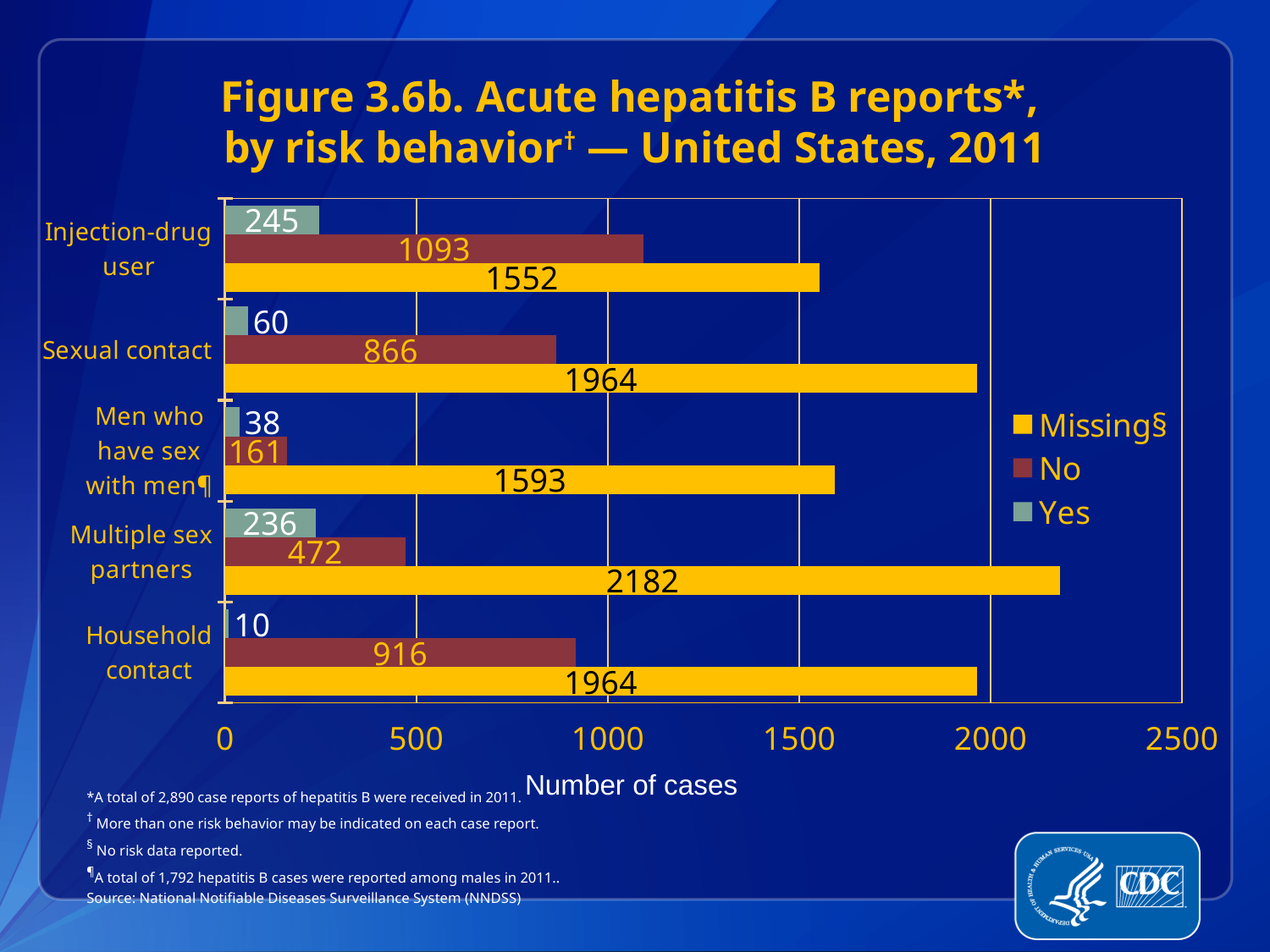
What kind of chart is shown on the slide? Bar chart What is the difference between the 'No' values for Injection-drug user and Sexual contact? 227 How many risk behavior categories are shown on the chart? 5 What is the label of the x axis? Number of cases How many series does the legend list? 3 What is the 'Missing' value for Multiple sex partners? 2182 Is the 'Missing' value for Injection-drug user greater or less than 1500? greater Which risk behavior has the highest 'Yes' value? Injection-drug user Which is larger, the 'Yes' value for Multiple sex partners or the 'Yes' value for Sexual contact? Multiple sex partners What is the 'No' value for Household contact? 916 What is the 'Yes' value for Injection-drug user? 245 Which risk behavior has the lowest 'Yes' value? Household contact